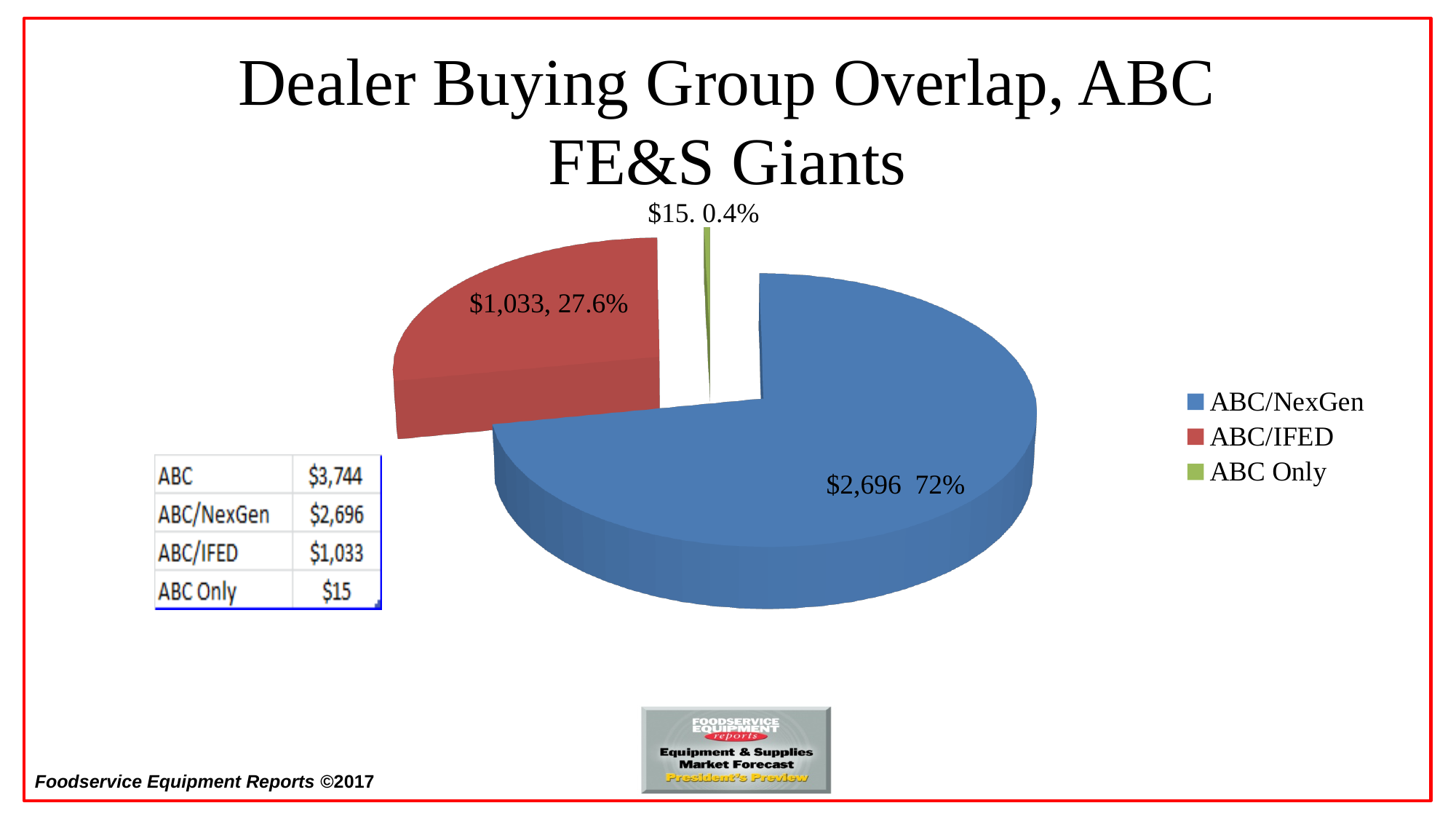
What is the value for ABC/NexGen in the pie chart? $2,696 What is the value for ABC Only in the pie chart? $15 What share of the pie does ABC/IFED represent? 27.6% Which slice of the pie chart is the smallest? ABC Only What share of the pie does ABC/NexGen represent? 72% What is the value for ABC/IFED in the pie chart? $1,033 How many slices does the pie chart have? 3 What colour is the ABC/IFED slice in the pie chart? red What share of the pie does ABC Only represent? 0.4% Which slice of the pie chart is the largest? ABC/NexGen What is the difference between the ABC/NexGen and ABC/IFED values? $1,663 What type of chart is shown on the slide? pie chart